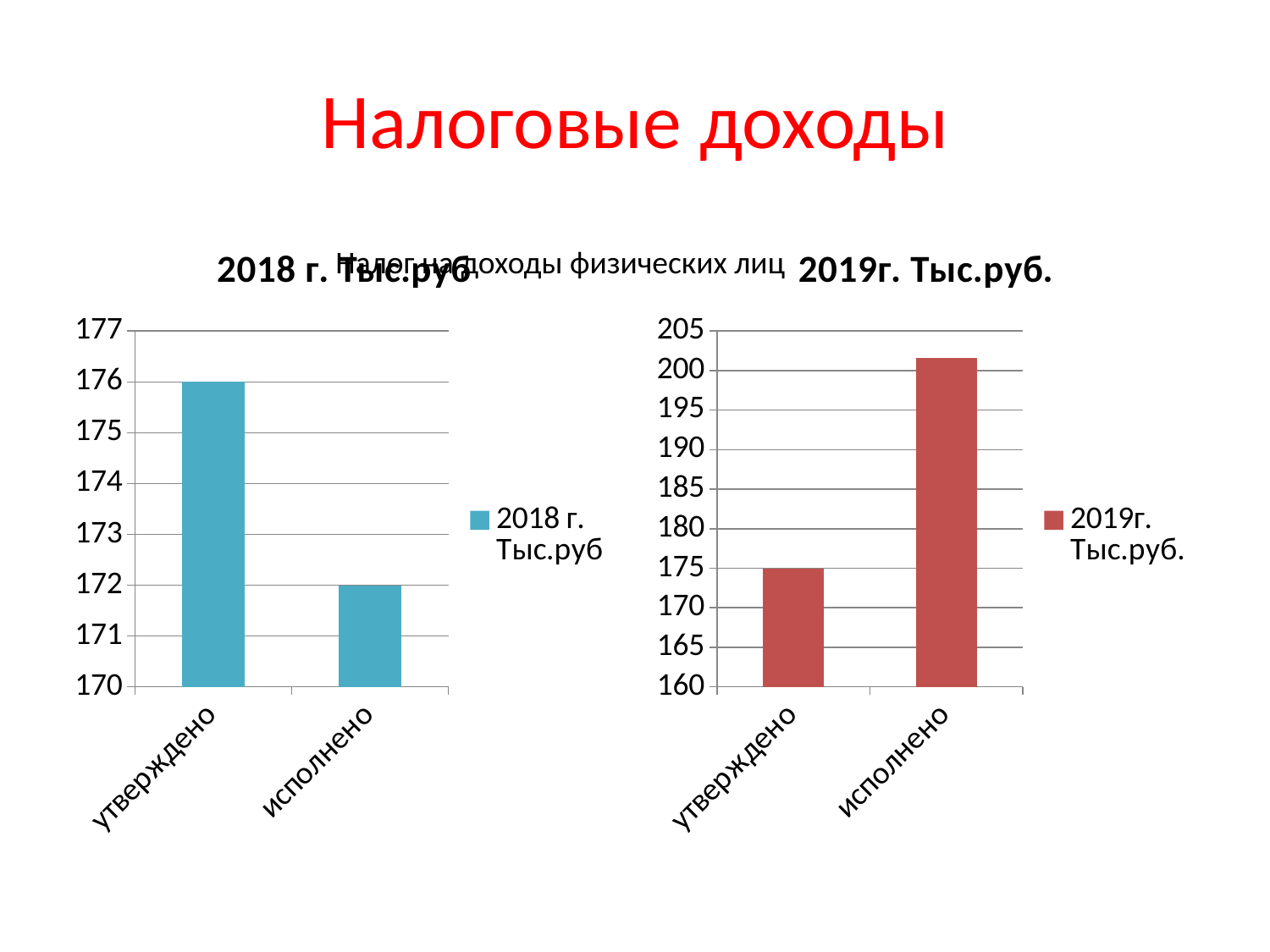
In the right chart (2019г. Тыс.руб.), what is the value for утверждено? 175 In the left chart (2018 г. Тыс.руб), what is the difference between утверждено and исполнено? 4 What kind of chart is the right chart (2019г. Тыс.руб.)? bar chart How many categories are shown in the left chart (2018 г. Тыс.руб)? 2 In the left chart (2018 г. Тыс.руб), what is the value for исполнено? 172 In the left chart (2018 г. Тыс.руб), what is the value for утверждено? 176 In the right chart (2019г. Тыс.руб.), is the value for исполнено greater or less than 200? greater In the left chart (2018 г. Тыс.руб), which category has the higher value? утверждено What is the legend entry of the left chart? 2018 г. Тыс.руб In the right chart (2019г. Тыс.руб.), is the value for исполнено larger or smaller than the value for утверждено? larger How many series does the legend of the right chart (2019г. Тыс.руб.) list? 1 In the right chart (2019г. Тыс.руб.), which category has the lowest value? утверждено